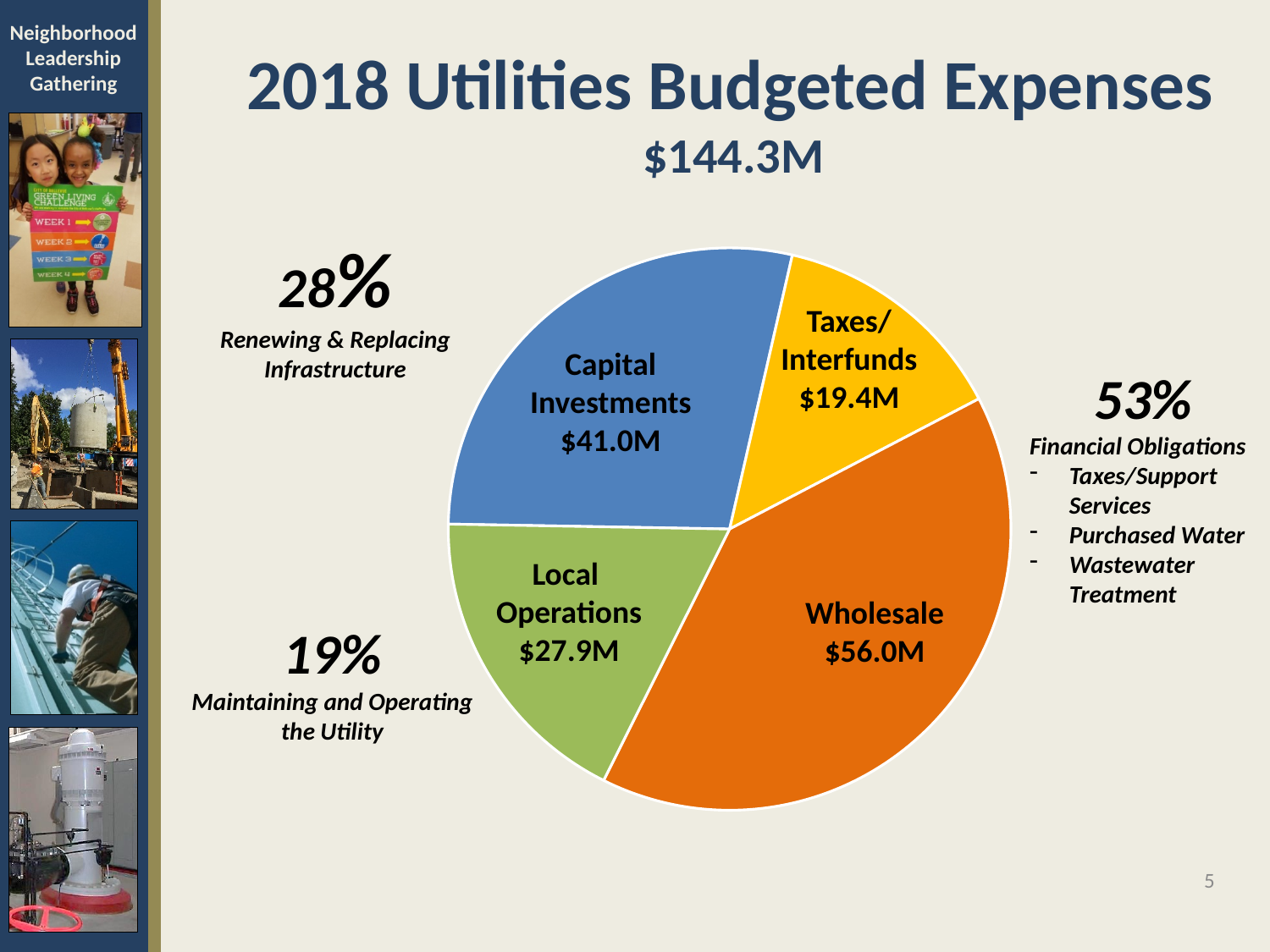
What is the budgeted expense for Taxes/Interfunds? $19.4M What is the total of the 2018 Utilities Budgeted Expenses shown on the slide? $144.3M What is the budgeted expense for Local Operations? $27.9M What is the budgeted expense for Capital Investments? $41.0M What percentage of the budget is labeled as Renewing & Replacing Infrastructure? 28% What is the budgeted expense for Wholesale? $56.0M What type of chart is shown on the slide? Pie chart Which category has the largest budgeted expense? Wholesale What is the difference between the Wholesale and Capital Investments expenses? $15.0M Which is larger, Capital Investments or Local Operations? Capital Investments Which category has the smallest budgeted expense? Taxes/Interfunds How many slices does the pie chart have? 4